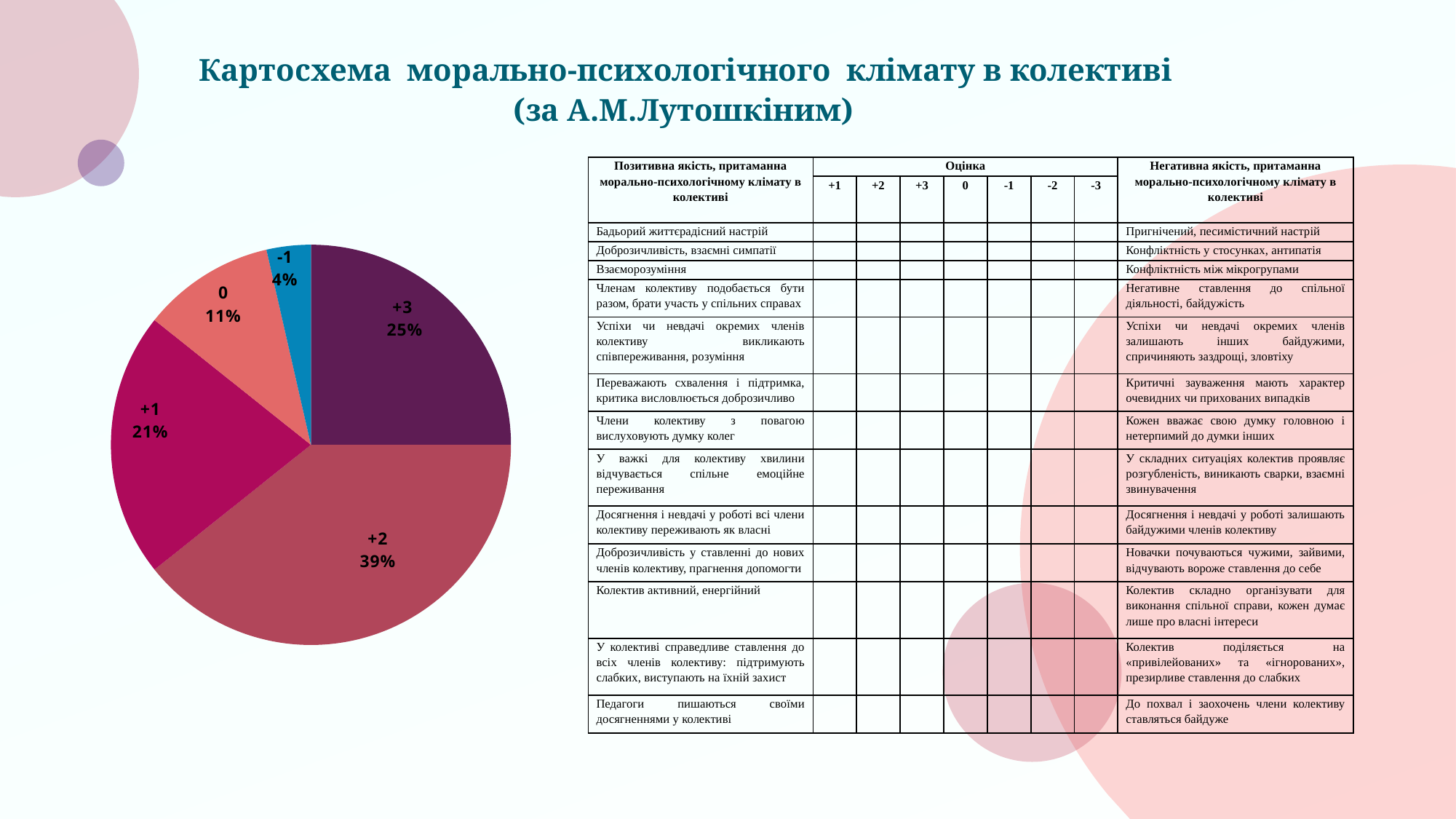
What share of the pie chart does the "+2" slice represent? 39% Which slice of the pie chart is the largest? +2 Which slice of the pie chart is the smallest? -1 What kind of chart is shown on the left of the slide? pie chart What is the value shown for the "+1" slice in the pie chart? 21% What is the value shown for the "-1" slice in the pie chart? 4% In the pie chart, what is the difference between the "+2" share and the "+3" share? 14% In the pie chart, what is the combined share of the "0" and "-1" slices? 15% What is the value shown for the "0" slice in the pie chart? 11% In the pie chart, which is larger: the "+1" slice or the "0" slice? +1 What share of the pie chart does the "+3" slice represent? 25% How many slices does the pie chart have? 5